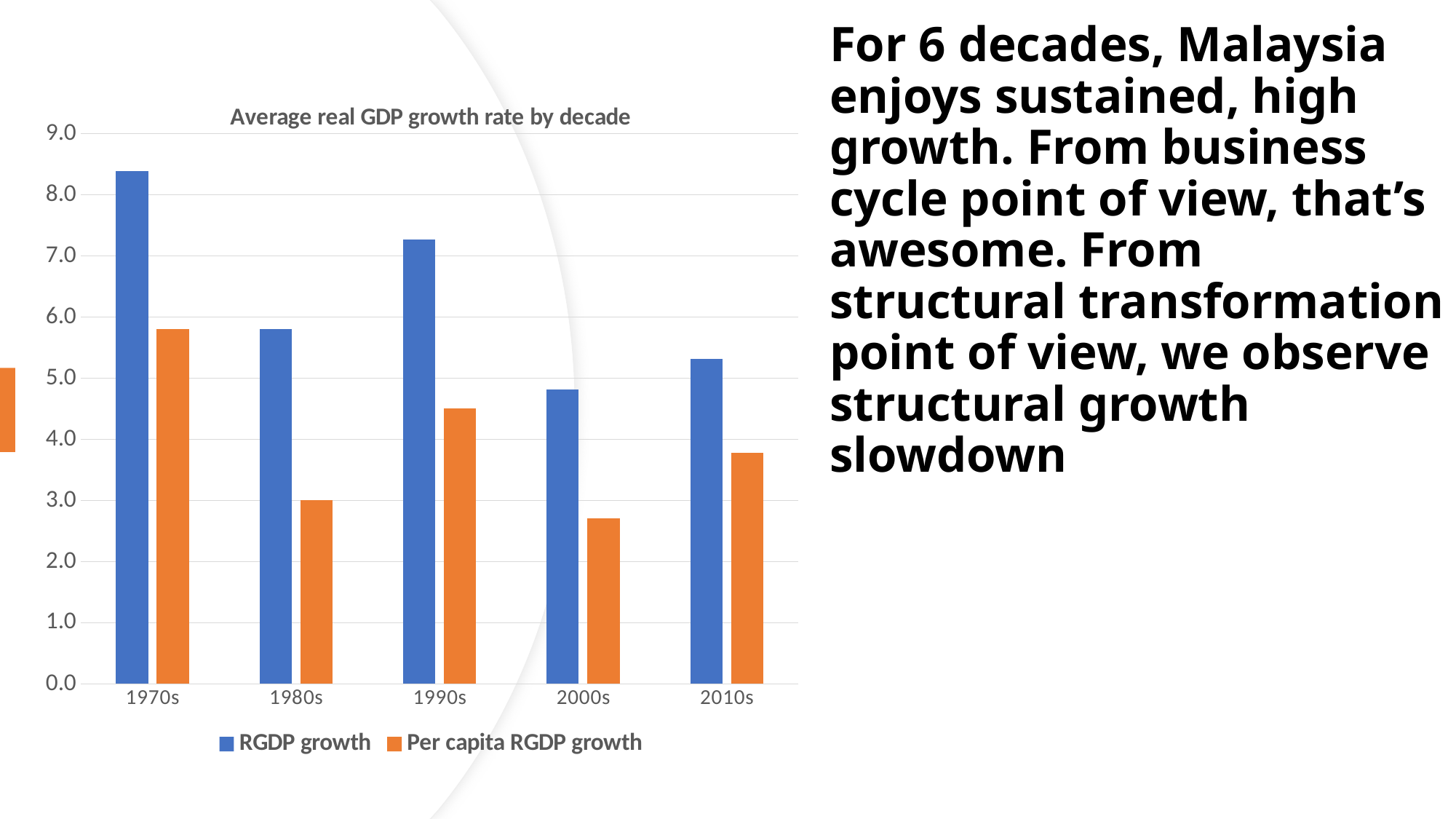
What kind of chart is shown on the slide? Bar chart Which decade has the lowest Per capita RGDP growth? 2000s Which is larger, RGDP growth in the 1980s or RGDP growth in the 2010s? 1980s Is the RGDP growth value for the 1970s greater or less than 8.0? greater How many series does the legend list? 2 Which colour represents Per capita RGDP growth in the legend? Orange Which decade has the lowest RGDP growth? 2000s How many decades are shown on the x axis? 5 Which decade has the highest RGDP growth? 1970s What is the title of the chart? Average real GDP growth rate by decade Is the RGDP growth value for the 1990s greater or less than 7.0? greater Is the Per capita RGDP growth value for the 2000s greater or less than 3.0? less